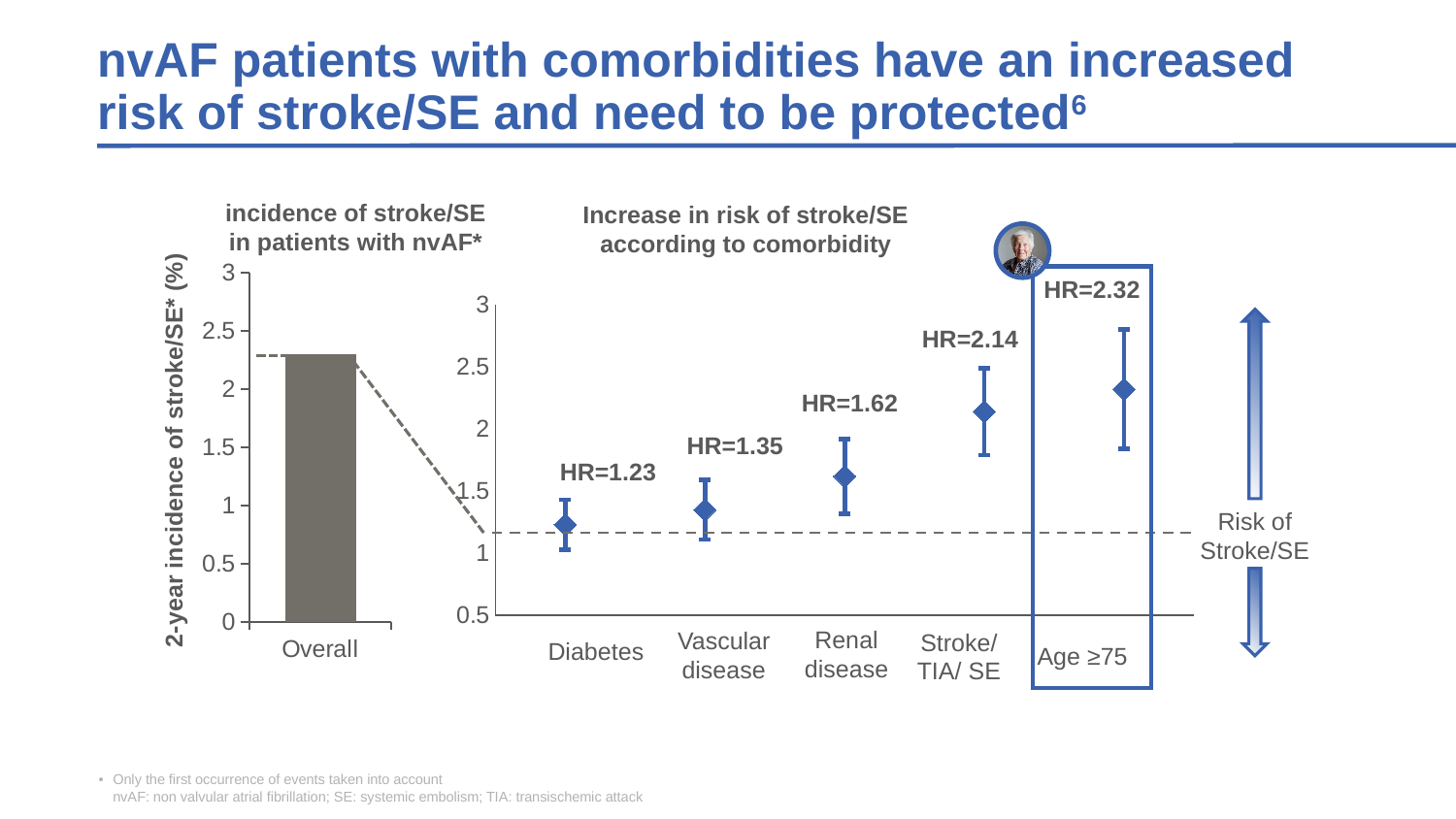
What kind of chart is the left chart 'incidence of stroke/SE in patients with nvAF*'? bar chart In the chart 'Increase in risk of stroke/SE according to comorbidity', which comorbidity has the highest HR? Age ≥75 In the chart 'Increase in risk of stroke/SE according to comorbidity', which category is highlighted with a blue box? Age ≥75 In the chart 'Increase in risk of stroke/SE according to comorbidity', what is the difference between the HR for Age ≥75 and the HR for Diabetes? 1.09 In the chart 'Increase in risk of stroke/SE according to comorbidity', do the HR values rise or fall from left to right along the x axis? rise In the chart 'Increase in risk of stroke/SE according to comorbidity', how many comorbidity categories are shown on the x axis? 5 In the chart 'Increase in risk of stroke/SE according to comorbidity', which has a higher HR: Renal disease or Vascular disease? Renal disease In the chart 'Increase in risk of stroke/SE according to comorbidity', what is the HR value for Diabetes? 1.23 In the chart 'Increase in risk of stroke/SE according to comorbidity', which comorbidity has the lowest HR? Diabetes In the chart 'Increase in risk of stroke/SE according to comorbidity', what is the HR value for Age ≥75? 2.32 In the left chart 'incidence of stroke/SE in patients with nvAF*', is the value for Overall greater or less than 2? greater In the chart 'Increase in risk of stroke/SE according to comorbidity', what is the HR value for Stroke/TIA/SE? 2.14